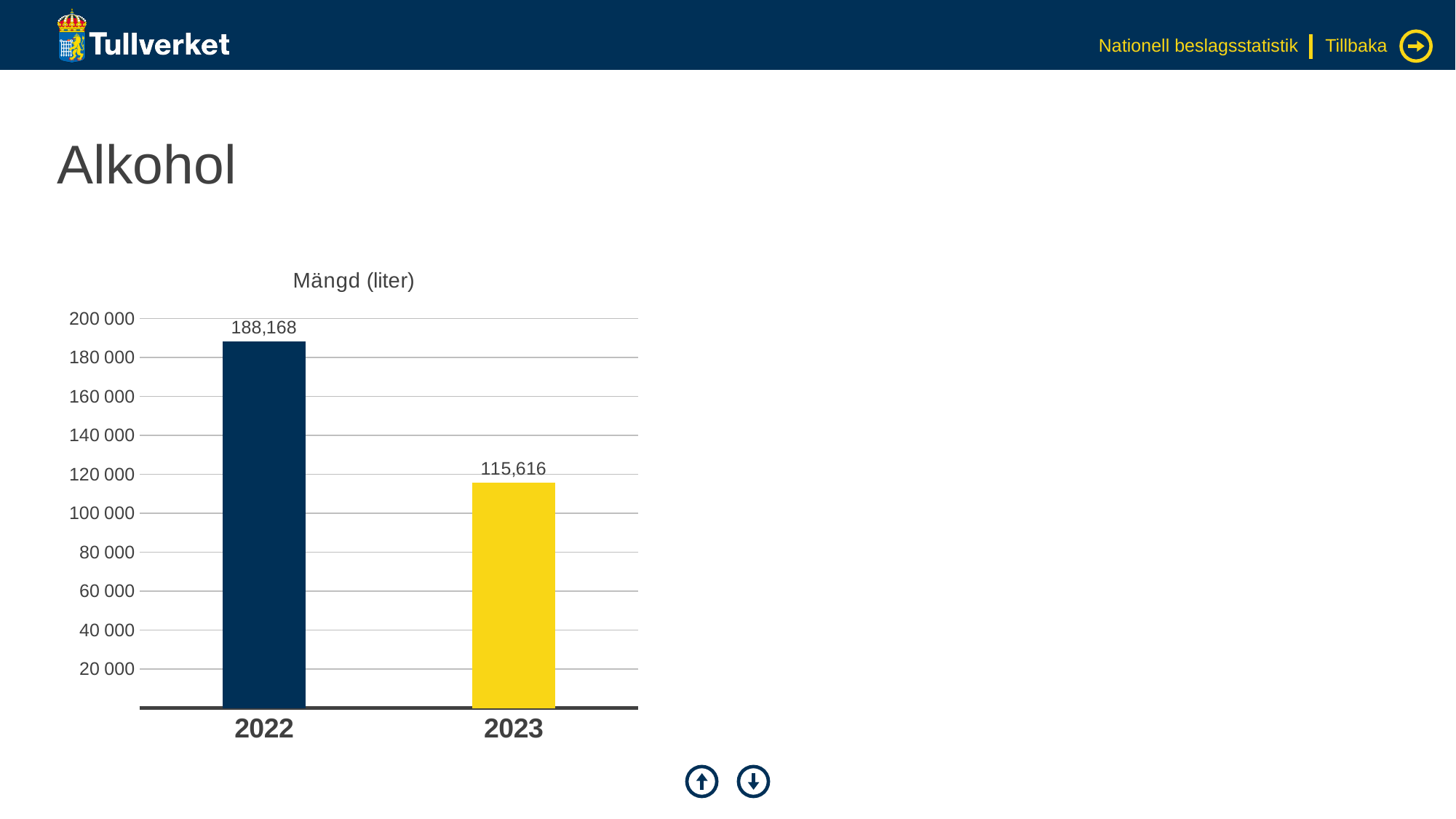
What is the value for 2023 in the Mängd (liter) chart? 115,616 What is the difference between the 2022 and 2023 values? 72,552 Is the value for 2023 greater or less than 120 000? less What kind of chart is shown on the slide? bar chart What is the value for 2022 in the Mängd (liter) chart? 188,168 Which is larger, the value for 2022 or the value for 2023? 2022 How many years are shown on the x axis of the chart? 2 Do the values rise or fall from 2022 to 2023? fall Which year has the lowest value in the chart? 2023 What is the title of the chart? Mängd (liter) Is the value for 2022 greater or less than 180 000? greater Which year has the highest value in the chart? 2022